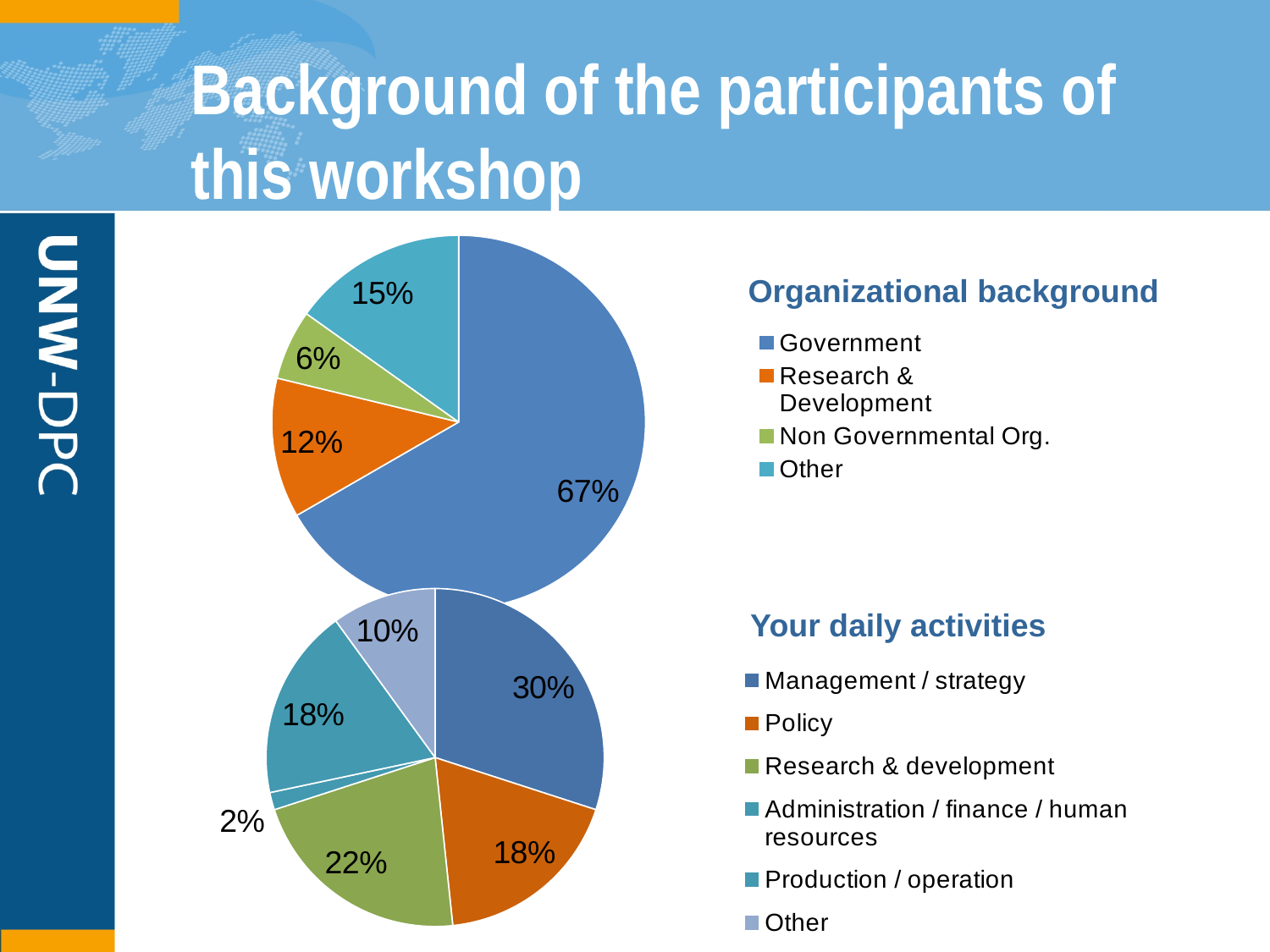
What type of chart is used for Your daily activities? Pie chart In the Your daily activities pie chart, what share is Management / strategy? 30% In the Organizational background pie chart, what percentage is Research & Development? 12% In the Your daily activities pie chart, which is larger: Policy or Other? Policy In the Organizational background pie chart, what share of participants are from Government? 67% In the Your daily activities pie chart, which category has the smallest share? Administration / finance / human resources How many categories does the Organizational background pie chart show? 4 In the Organizational background pie chart, which category has the largest share? Government In the Organizational background pie chart, which category has the smallest share? Non Governmental Org. In the Your daily activities pie chart, what percentage is Research & development? 22% In the Organizational background pie chart, what is the difference between the Other share and the Non Governmental Org. share? 9% How many categories are listed in the legend of the Your daily activities pie chart? 6